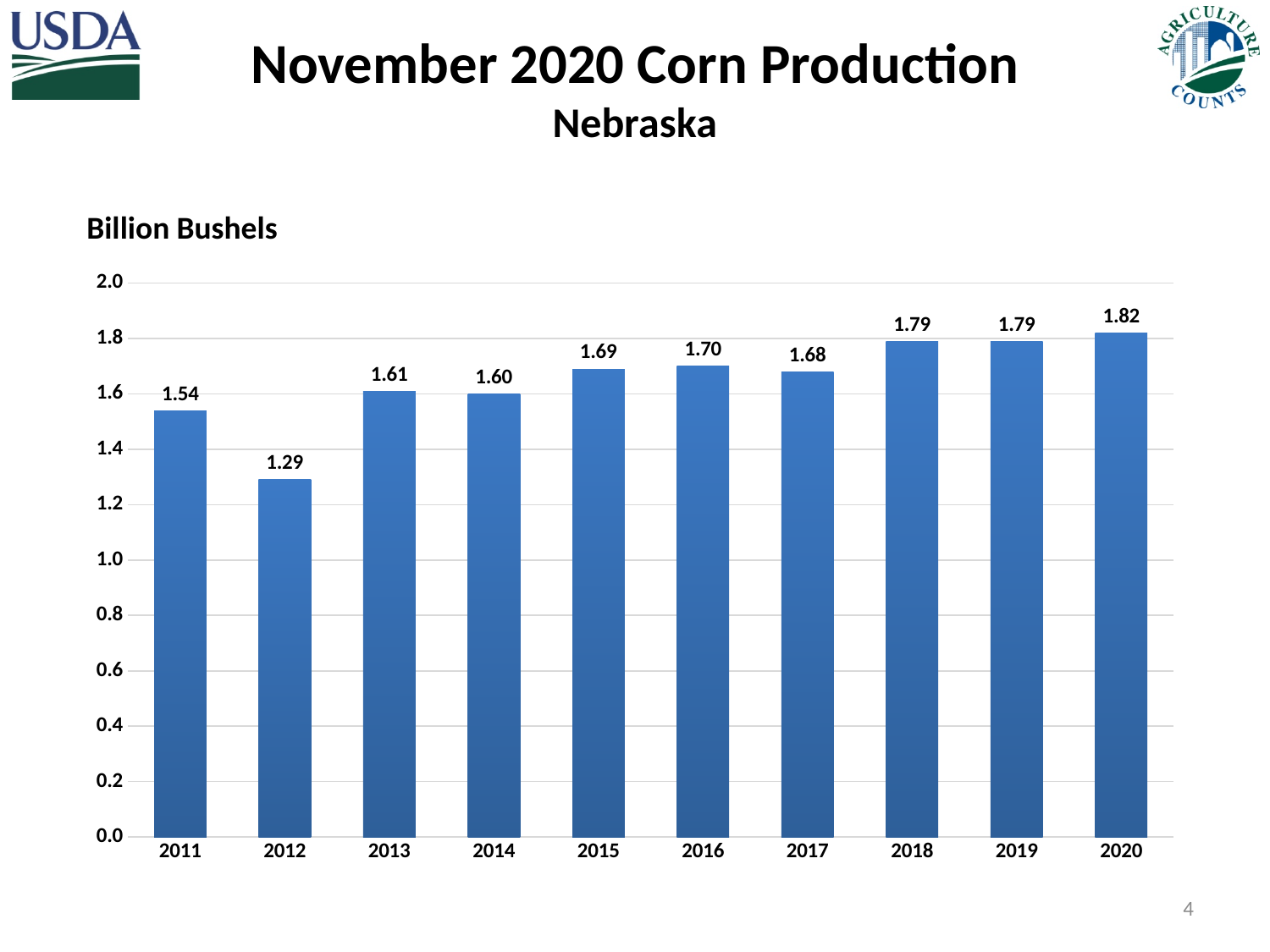
What value is shown for 2020? 1.82 Which year has the lowest corn production? 2012 What is the difference between the 2020 value and the 2011 value? 0.28 Is the value for 2012 greater or less than 1.4? less What kind of chart is shown on the slide? bar chart How many years are shown on the x axis? 10 What was the corn production value for 2016? 1.70 Which year had higher corn production, 2015 or 2017? 2015 What is the difference between the 2013 value and the 2012 value? 0.32 Which year has the highest corn production? 2020 What unit is the y axis measured in, according to the label above the chart? Billion Bushels What was Nebraska's corn production in 2012, in billion bushels? 1.29